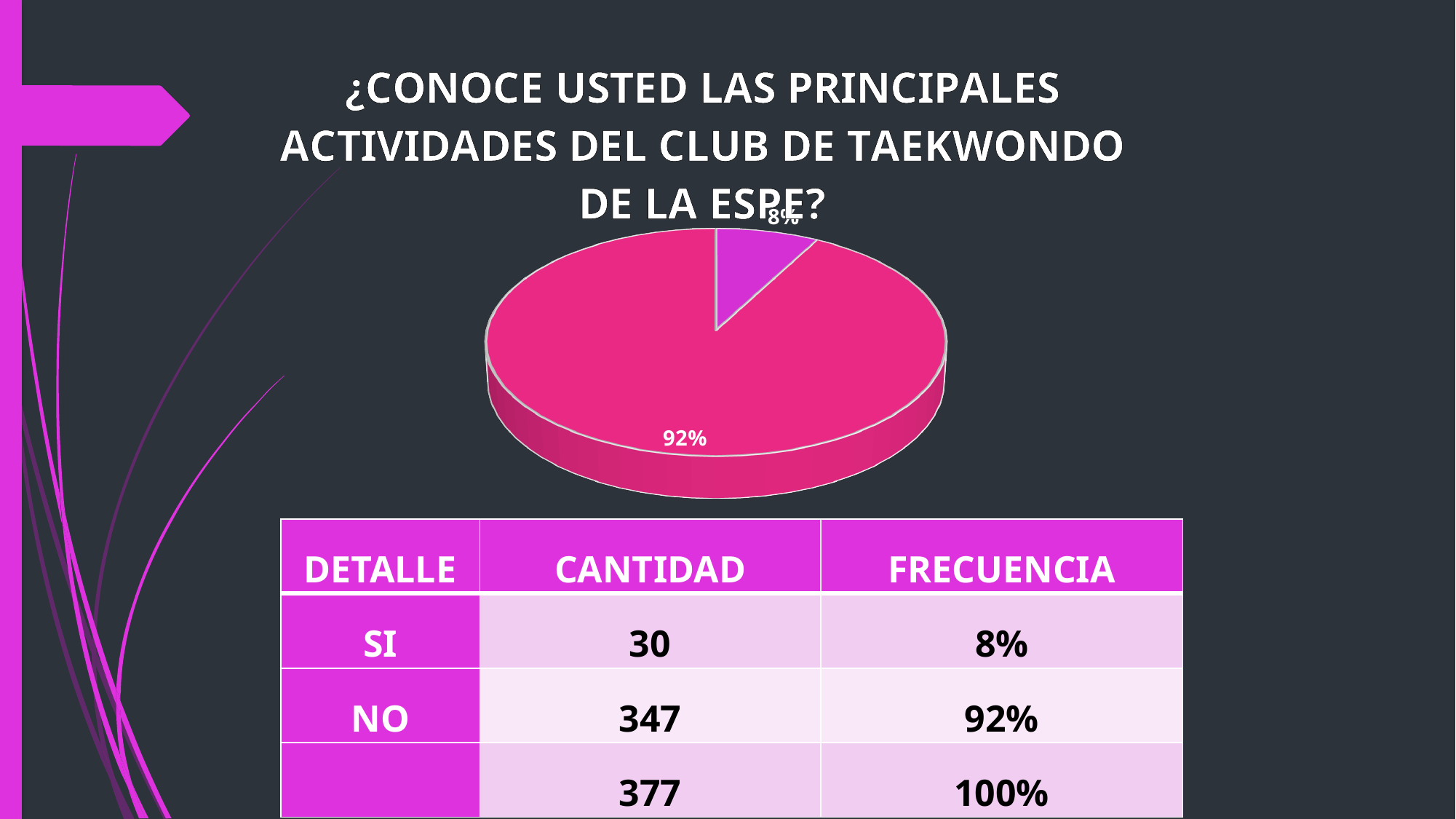
Which response, SI or NO, has the larger slice in the pie chart? NO How many slices does the pie chart have? 2 According to the table, what share of the pie corresponds to SI? 8% What is the total CANTIDAD shown in the table below the chart? 377 What is the difference in percentage points between the two slices of the pie chart? 84 What percentage is shown on the smallest slice of the pie chart? 8% What kind of chart is shown on the slide? pie chart What percentage is shown on the largest slice of the pie chart? 92% According to the table, what share of the pie corresponds to NO? 92% Which response has the smallest slice in the pie chart? SI What colour is the 8% slice of the pie chart? purple What is the CANTIDAD value for NO in the table below the chart? 347